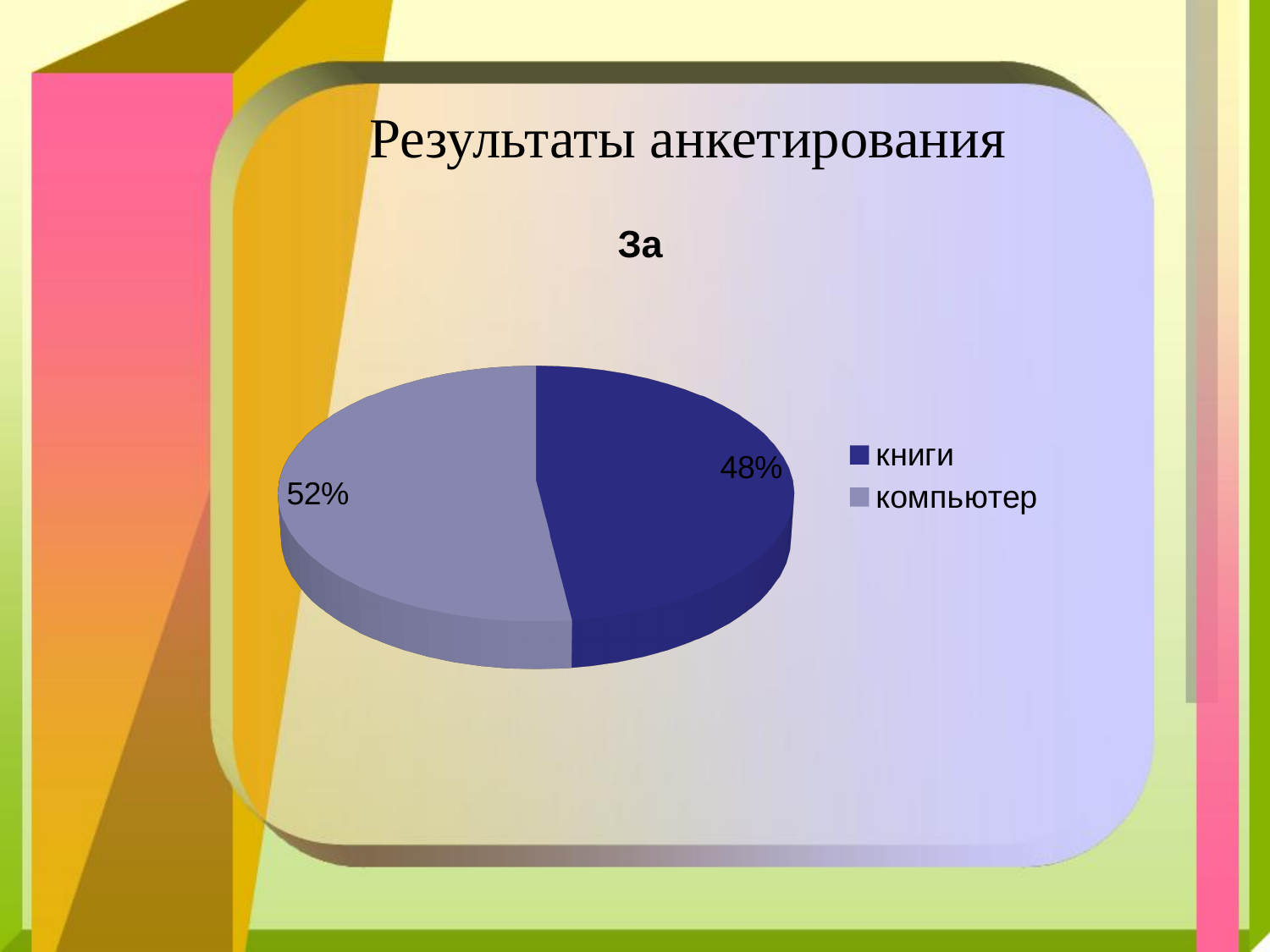
Which legend entry is shown in the darker blue colour? книги What is the difference between the shares for компьютер and книги? 4% How many entries does the legend list? 2 What percentage is shown for компьютер? 52% Which category has the largest share of the pie? компьютер What kind of chart is shown on the slide? pie chart How many slices does the pie chart have? 2 What percentage is shown for книги? 48% Which category has the smallest share of the pie? книги What is the chart's title? За Is the share for книги greater or less than 50%? less Which is larger, the share for книги or the share for компьютер? компьютер